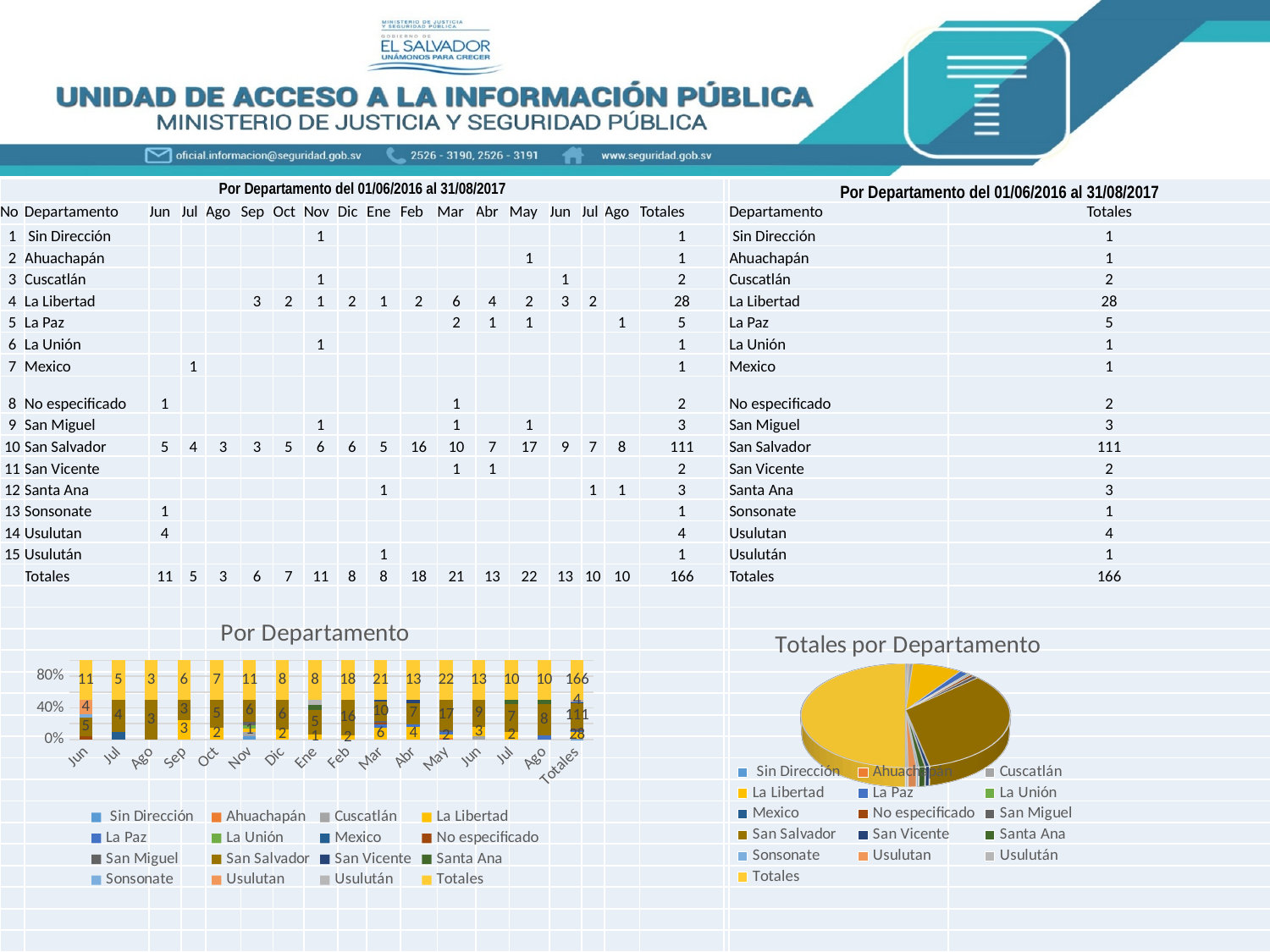
What kind of chart is the 'Totales por Departamento' chart on the right? pie chart In the 'Por Departamento' bar chart, how many categories are shown along the x axis? 16 What is the title of the pie chart on the right of the slide? Totales por Departamento In the 'Por Departamento' bar chart, what is the Totales value labelled at the top of the Totales bar? 166 In the 'Por Departamento' bar chart, which monthly category has the highest Totales label? May In the 'Por Departamento' bar chart, what is the difference between the Totales labels for Mar and Feb? 3 What kind of chart is the 'Por Departamento' chart on the left? bar chart In the 'Por Departamento' bar chart, what is the Totales value labelled at the top of the Mar bar? 21 How many entries does the legend of the 'Por Departamento' bar chart list? 16 In the 'Por Departamento' bar chart, which has the larger Totales label, Feb or Abr? Feb In the 'Por Departamento' bar chart, what is the Totales value labelled at the top of the May bar? 22 How many entries does the legend of the 'Totales por Departamento' pie chart list? 16